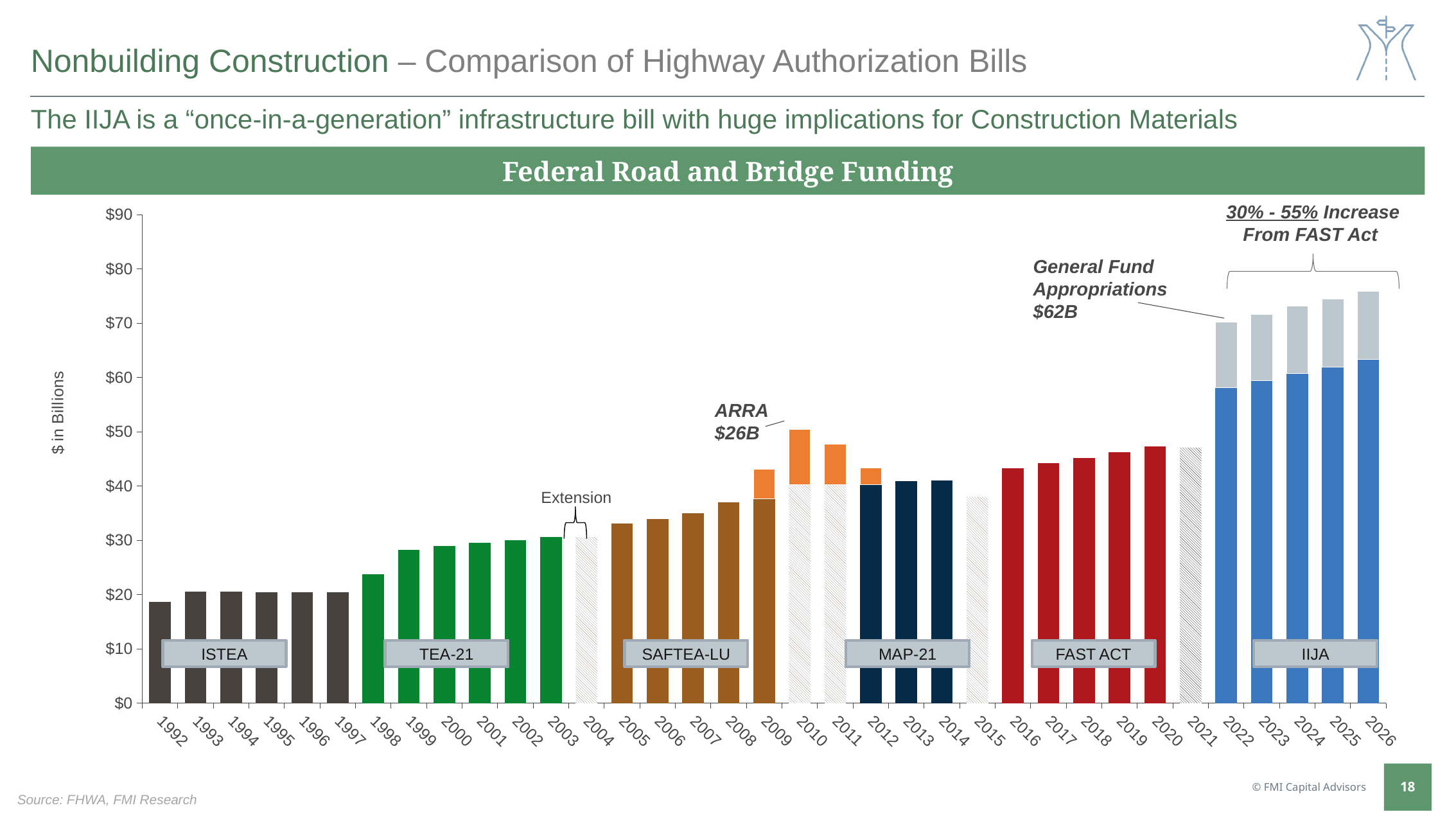
Which year has the highest federal road and bridge funding in the chart? 2026 What type of chart is shown on the slide? bar chart How many years are shown along the x axis of the chart? 35 Which year has higher funding, 2009 or 2010? 2010 Is the value for 2015 greater or less than $40? less Which year has the lowest federal road and bridge funding in the chart? 1992 What is the title of the chart? Federal Road and Bridge Funding Is the value for 2020 greater or less than $50? less Is the value for 1992 greater or less than $20? less Do federal road and bridge funding values generally rise or fall from 1992 to 2026? rise What is the label on the vertical axis of the chart? $ in Billions